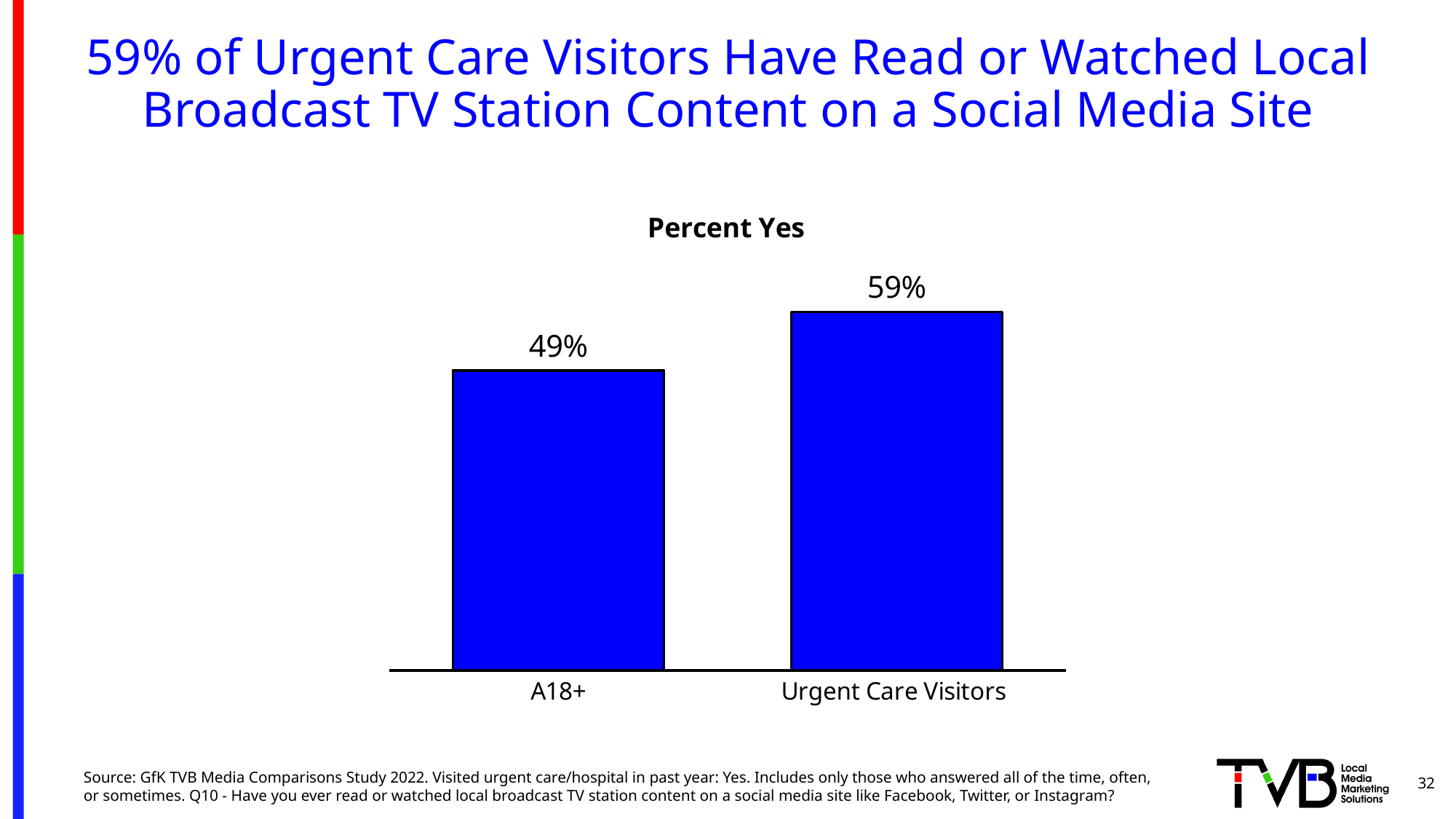
Which category has the lower Percent Yes value? A18+ What kind of chart is shown on the slide? Bar chart What is the difference in Percent Yes between Urgent Care Visitors and A18+? 10 percentage points Which category has the higher Percent Yes value? Urgent Care Visitors What is the title of the chart? Percent Yes What is the Percent Yes value for A18+? 49% What is the Percent Yes value for Urgent Care Visitors? 59% What colour are the bars in the chart? Blue Is the Percent Yes value larger for A18+ or for Urgent Care Visitors? Urgent Care Visitors How many categories are shown in the chart? 2